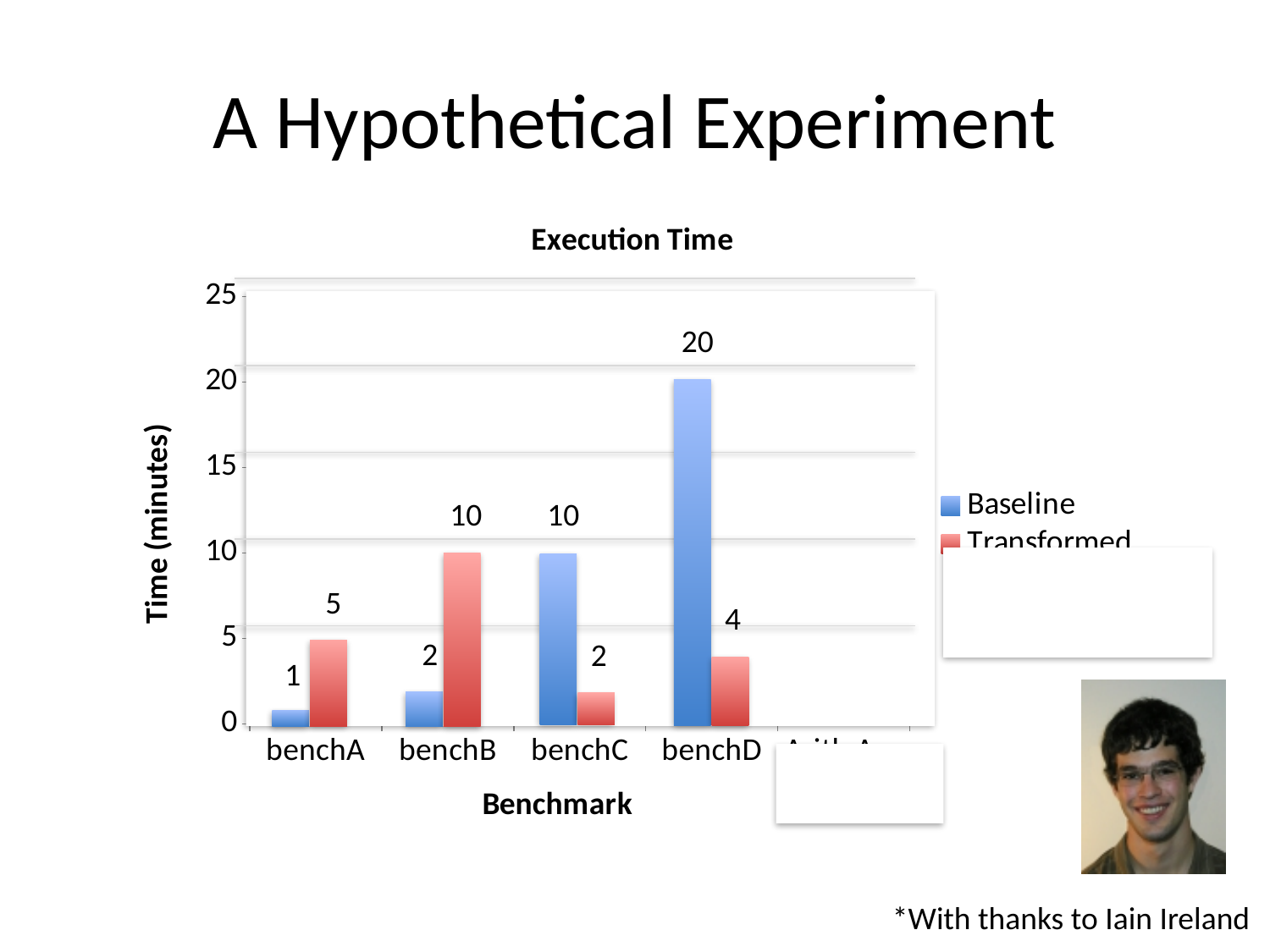
How many series does the legend list? 2 Which benchmark has the lowest Baseline execution time? benchA What is the Transformed execution time for benchB? 10 What is the difference between the Baseline and Transformed values for benchD? 16 For benchA, which is larger, the Baseline or the Transformed value? Transformed Which benchmark has the highest Baseline execution time? benchD For benchC, which is larger, the Baseline or the Transformed value? Baseline What is the Transformed value for benchD? 4 What kind of chart is shown on the slide? Bar chart What is the label of the y axis? Time (minutes) What is the Baseline execution time for benchD? 20 What is the Baseline value for benchA? 1